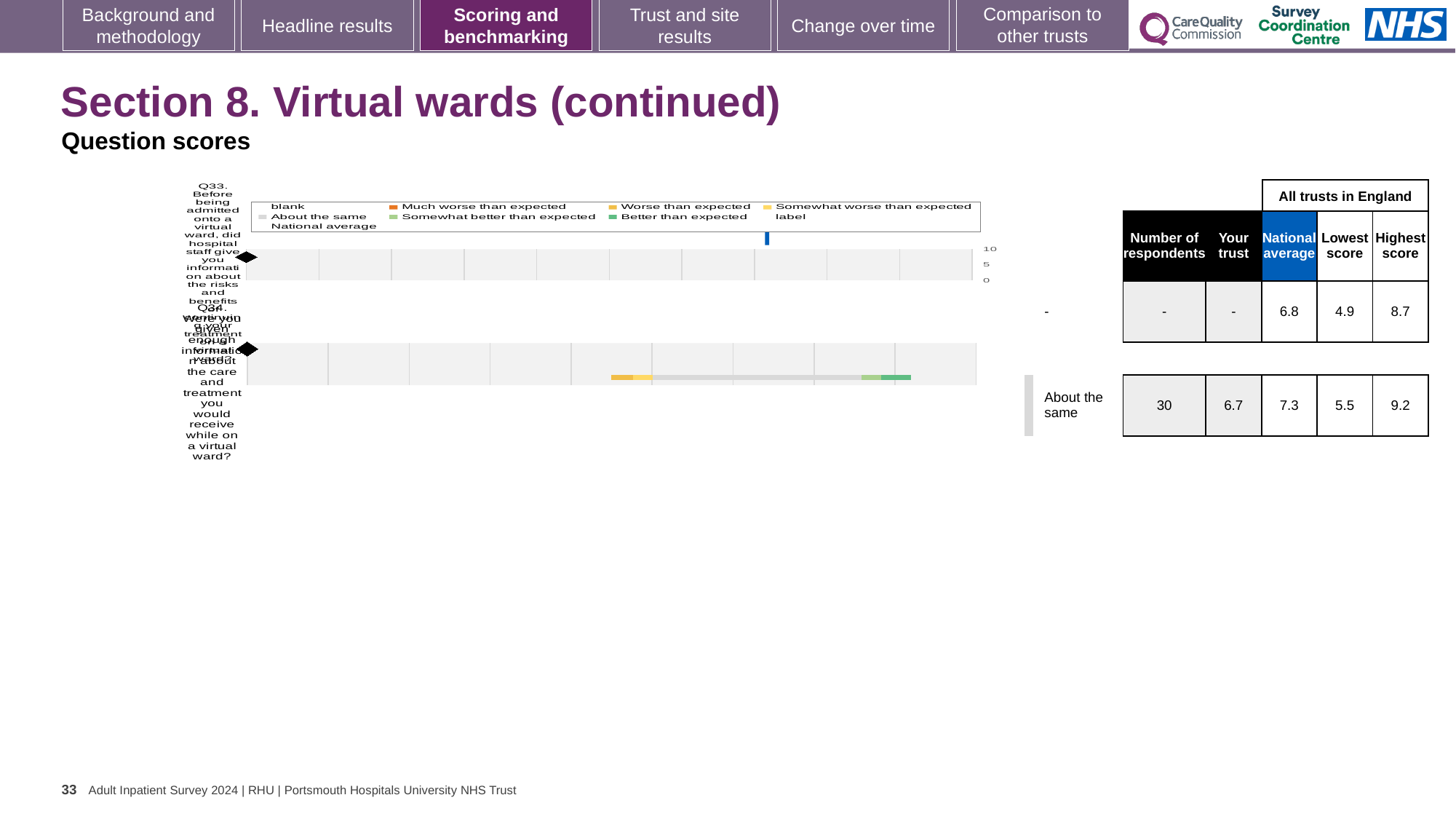
Which question has the higher national average, Q33 or Q34? Q34 What is the national average score for Q34? 7.3 What is the difference between the national average and the trust's score for Q34? 0.6 How many questions are plotted on the chart? 2 What is the highest score among all trusts in England for Q33? 8.7 What is the highest value shown on the chart's score axis? 10 What is the national average score for Q33? 6.8 What is the 'Your trust' score for Q34? 6.7 What kind of chart is shown on the slide? bar chart What is the lowest score among all trusts in England for Q34? 5.5 How many respondents answered Q34? 30 Which is larger for Q34: the trust's score or the national average? national average